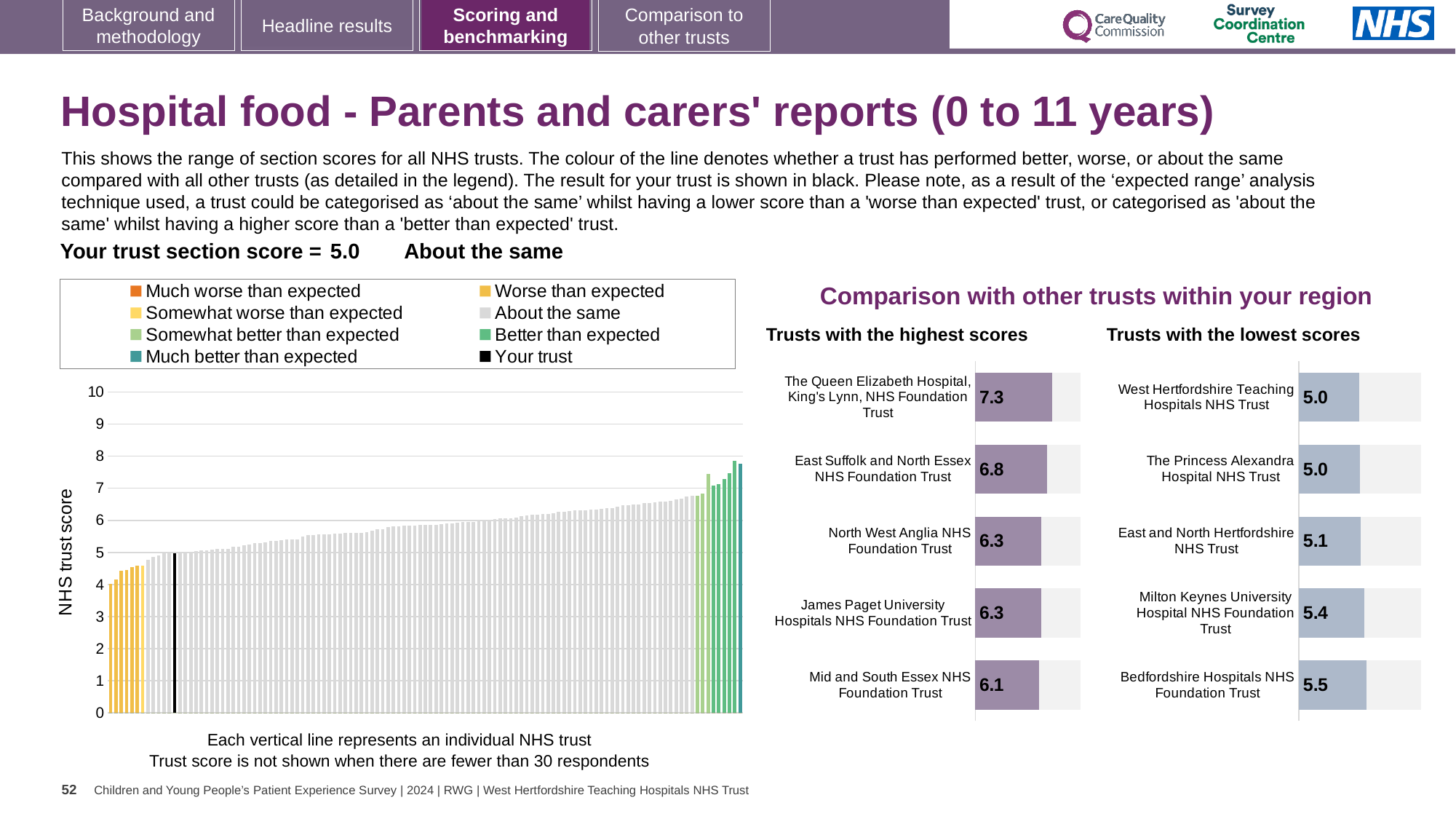
In the 'Trusts with the highest scores' chart, what is the score for The Queen Elizabeth Hospital, King's Lynn, NHS Foundation Trust? 7.3 In the 'Trusts with the lowest scores' chart, what is the score for Milton Keynes University Hospital NHS Foundation Trust? 5.4 In the 'Trusts with the lowest scores' chart, which has the larger score: East and North Hertfordshire NHS Trust or Bedfordshire Hospitals NHS Foundation Trust? Bedfordshire Hospitals NHS Foundation Trust How many trusts are shown in the 'Trusts with the lowest scores' chart? 5 In the 'Trusts with the highest scores' chart, which trust has the lowest score? Mid and South Essex NHS Foundation Trust In the main chart of NHS trust scores on the left, is the value of the tallest bar greater or less than 7? greater In the main chart of NHS trust scores on the left, do the bar values rise or fall from left to right? rise In the 'Trusts with the highest scores' chart, what is the difference between the scores of The Queen Elizabeth Hospital, King's Lynn, NHS Foundation Trust and East Suffolk and North Essex NHS Foundation Trust? 0.5 How many entries does the legend above the main chart of NHS trust scores list? 8 What kind of chart is the main chart of NHS trust scores on the left? bar chart In the 'Trusts with the highest scores' chart, what is the score for Mid and South Essex NHS Foundation Trust? 6.1 In the 'Trusts with the lowest scores' chart, which trust has the highest score? Bedfordshire Hospitals NHS Foundation Trust